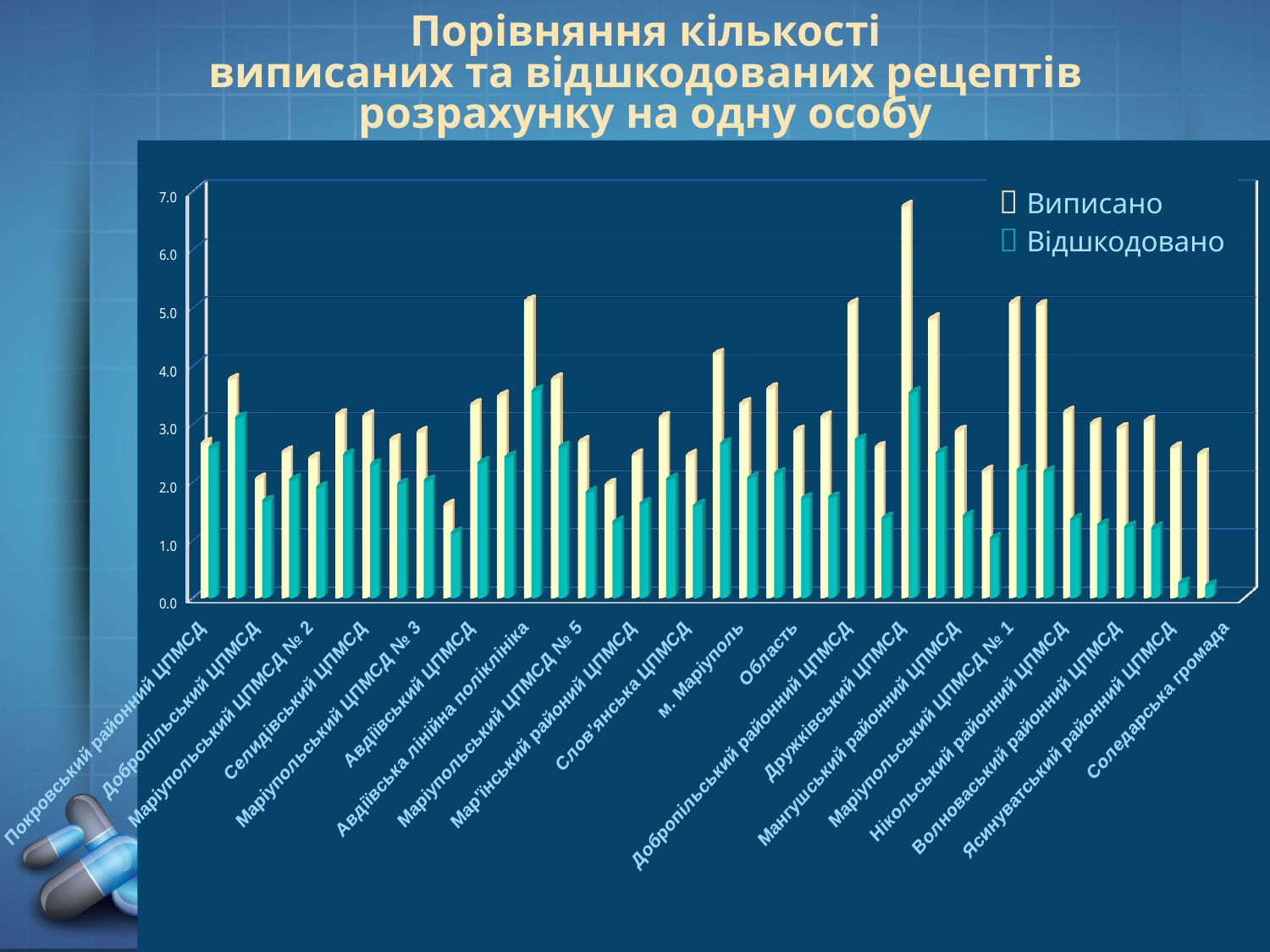
What is the maximum value shown on the vertical axis? 7.0 For Авдіївська лінійна поліклініка, which is larger: Виписано or Відшкодовано? Виписано Is the Виписано value for Добропільський ЦПМСД greater or less than 3.0? less What kind of chart is shown on the slide? bar chart What are the two series named in the legend? Виписано and Відшкодовано Is the Виписано value for Авдіївська лінійна поліклініка greater or less than 4.0? greater Which category has the highest Виписано value? Дружківський ЦПМСД Is the Виписано value for Область greater or less than 2.0? greater For Мар'їнський районний ЦПМСД, which is larger: Виписано or Відшкодовано? Виписано How many series does the legend list? 2